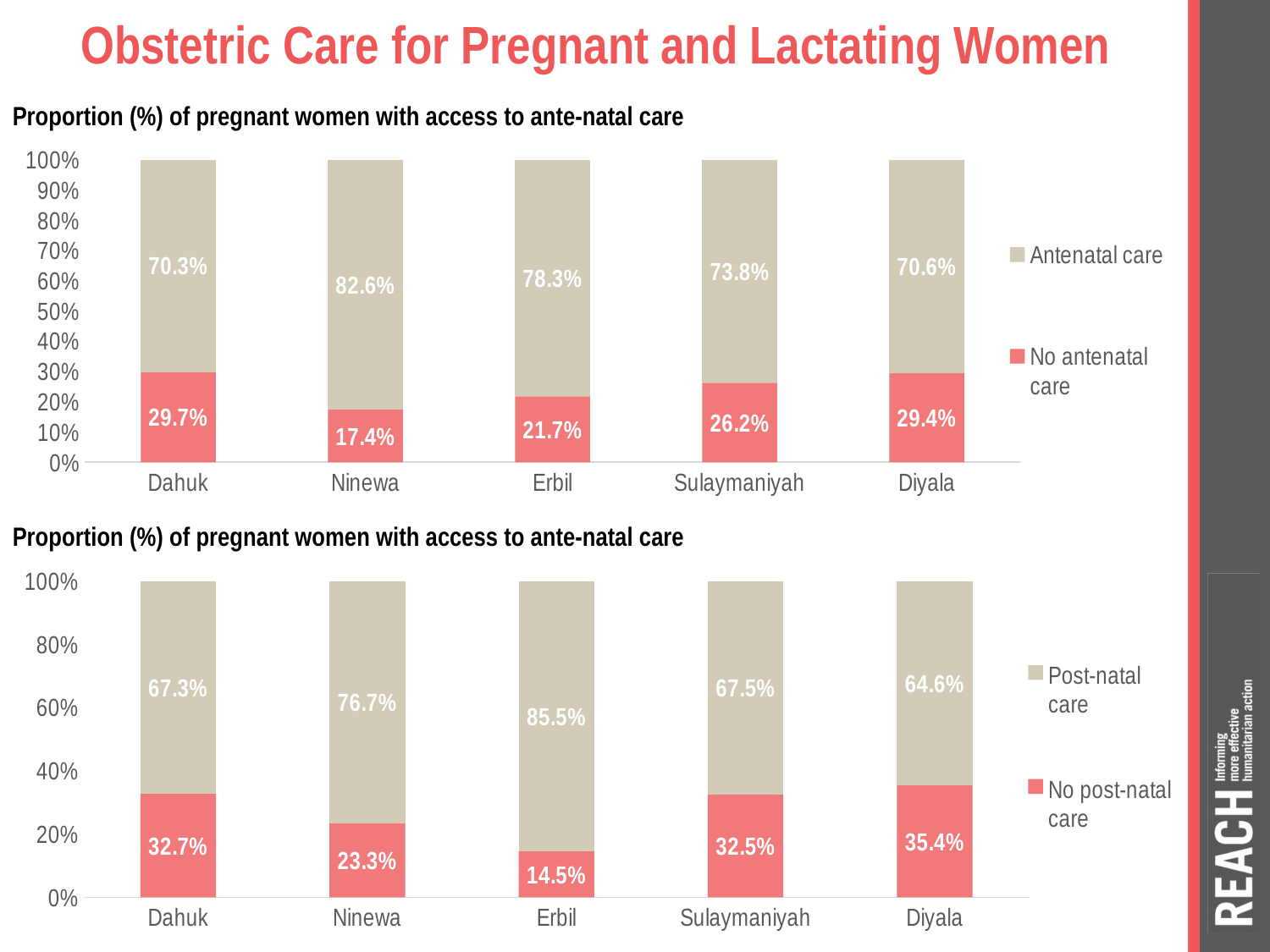
How many series does the legend of the bottom chart list? 2 In the bottom chart, which is larger: the Post-natal care value for Ninewa or for Sulaymaniyah? Ninewa How many governorates are shown on the x axis of the top chart? 5 In the bottom chart, which governorate has the lowest value for No post-natal care? Erbil What is the title of the slide? Obstetric Care for Pregnant and Lactating Women What kind of chart is the top chart? Stacked bar chart In the top chart, what is the value for No antenatal care in Sulaymaniyah? 26.2% In the top chart, which governorate has the highest value for Antenatal care? Ninewa In the top chart, what is the difference between the No antenatal care values for Dahuk and Ninewa? 12.3% In the bottom chart, what is the value for No post-natal care in Diyala? 35.4% In the bottom chart, what is the value for Post-natal care in Erbil? 85.5% In the top chart, what is the value for Antenatal care in Ninewa? 82.6%